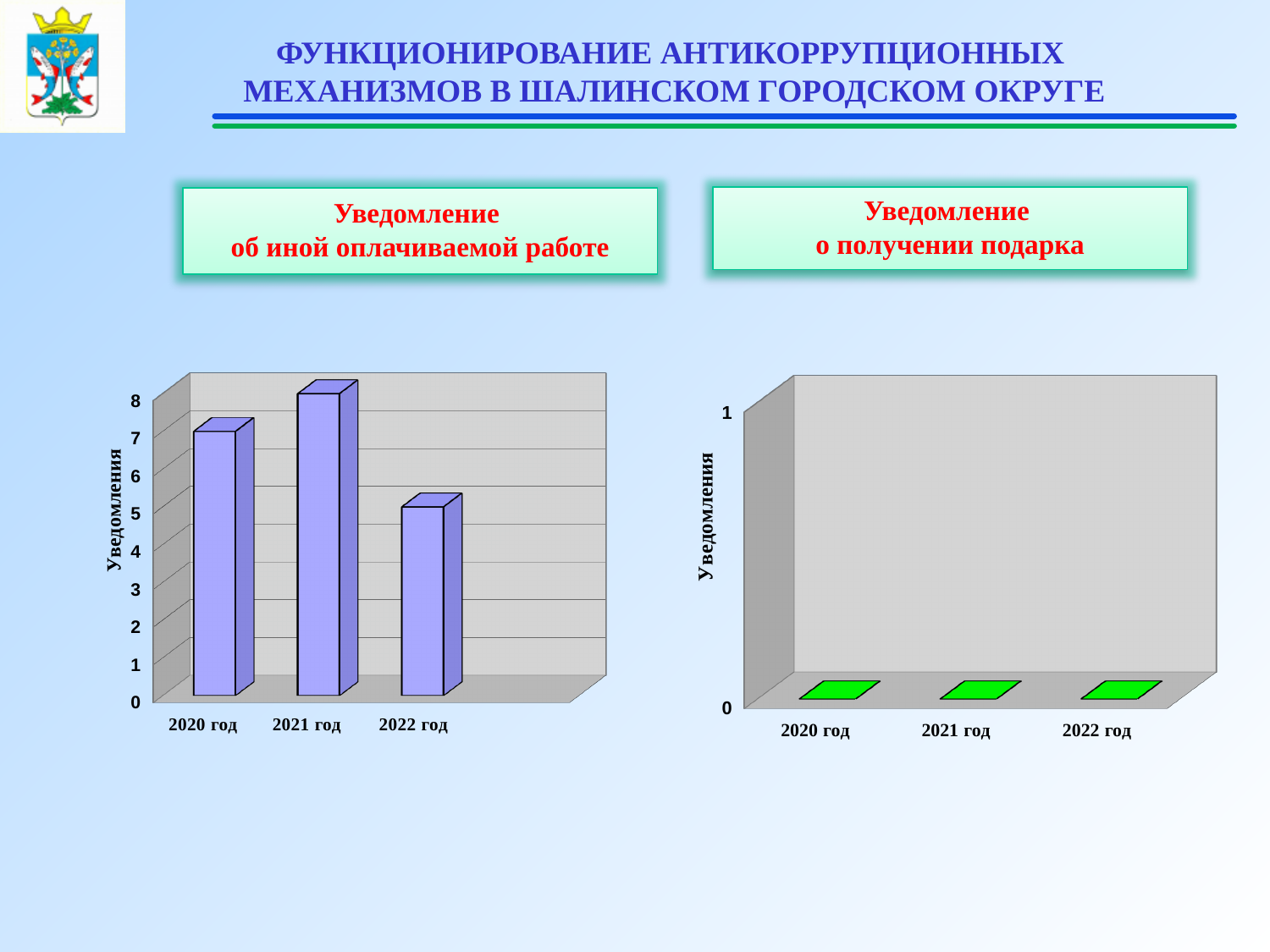
What kind of chart is the left chart (Уведомление об иной оплачиваемой работе)? Bar chart In the left chart (Уведомление об иной оплачиваемой работе), what is the difference between the values for 2021 год and 2022 год? 3 What is the y-axis label of the left chart (Уведомление об иной оплачиваемой работе)? Уведомления In the left chart (Уведомление об иной оплачиваемой работе), what is the value for 2022 год? 5 In the left chart (Уведомление об иной оплачиваемой работе), what is the value for 2021 год? 8 In the left chart (Уведомление об иной оплачиваемой работе), which year has the highest value? 2021 год In the right chart (Уведомление о получении подарка), how many years are shown on the x axis? 3 In the left chart (Уведомление об иной оплачиваемой работе), how many years are shown on the x axis? 3 In the left chart (Уведомление об иной оплачиваемой работе), which is larger, the value for 2020 год or 2022 год? 2020 год In the right chart (Уведомление о получении подарка), what is the value for 2021 год? 0 In the left chart (Уведомление об иной оплачиваемой работе), what is the value for 2020 год? 7 In the left chart (Уведомление об иной оплачиваемой работе), which year has the lowest value? 2022 год